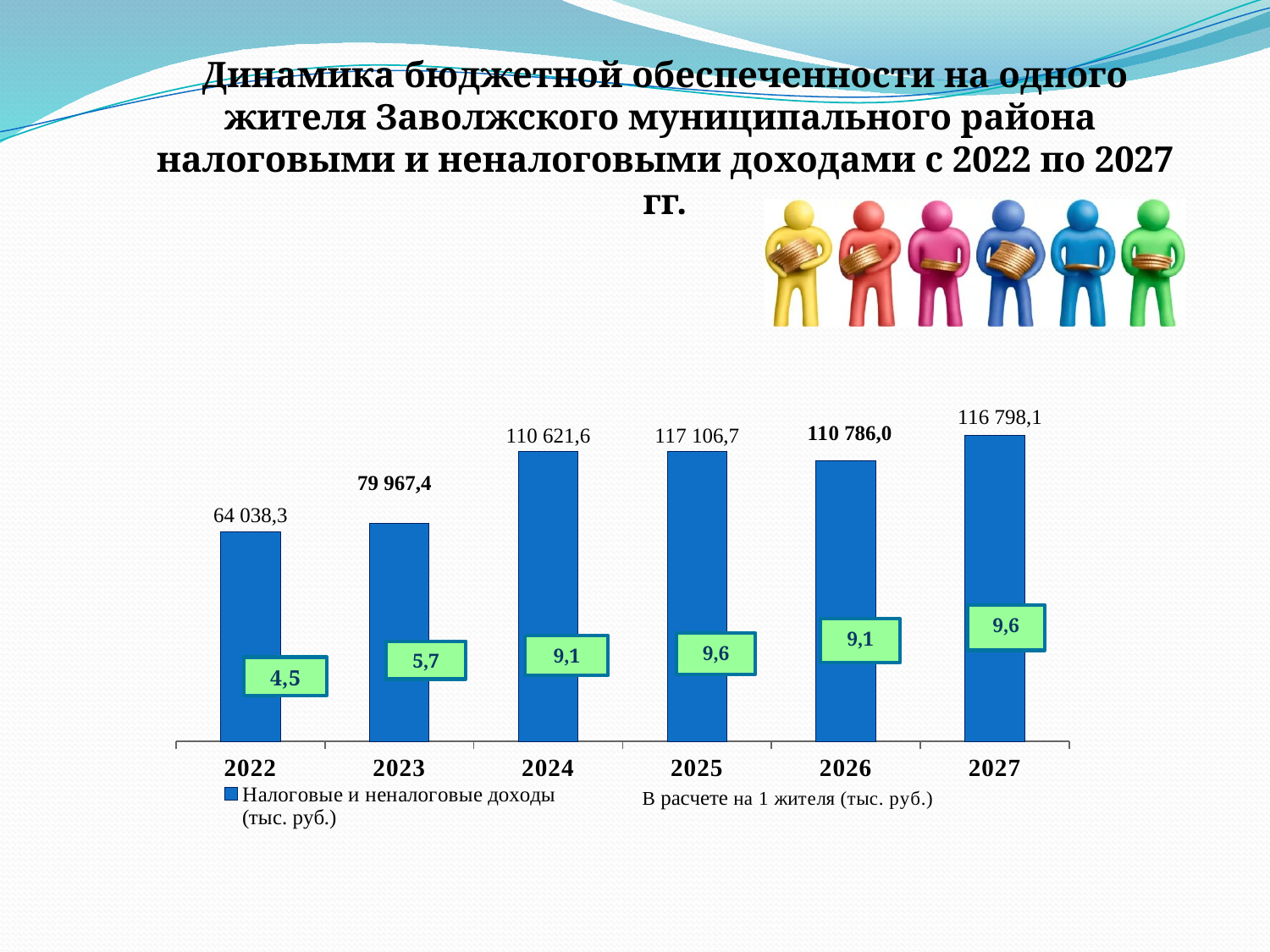
What kind of chart is shown on the slide? Bar chart Do the tax and non-tax revenue values rise or fall from 2022 to 2025? Rise What is the per-resident value (В расчете на 1 жителя) shown for 2027? 9,6 What is the difference between the per-resident values for 2027 and 2022? 5,1 What is the per-resident value (В расчете на 1 жителя) shown for 2024? 9,1 What is the value of tax and non-tax revenues (тыс. руб.) for 2025? 117 106,7 How many years are shown on the x axis of the chart? 6 What is the difference between the tax and non-tax revenues for 2023 and 2022? 15 929,1 Which year has the lowest value of tax and non-tax revenues? 2022 What is the value of tax and non-tax revenues (тыс. руб.) for 2022? 64 038,3